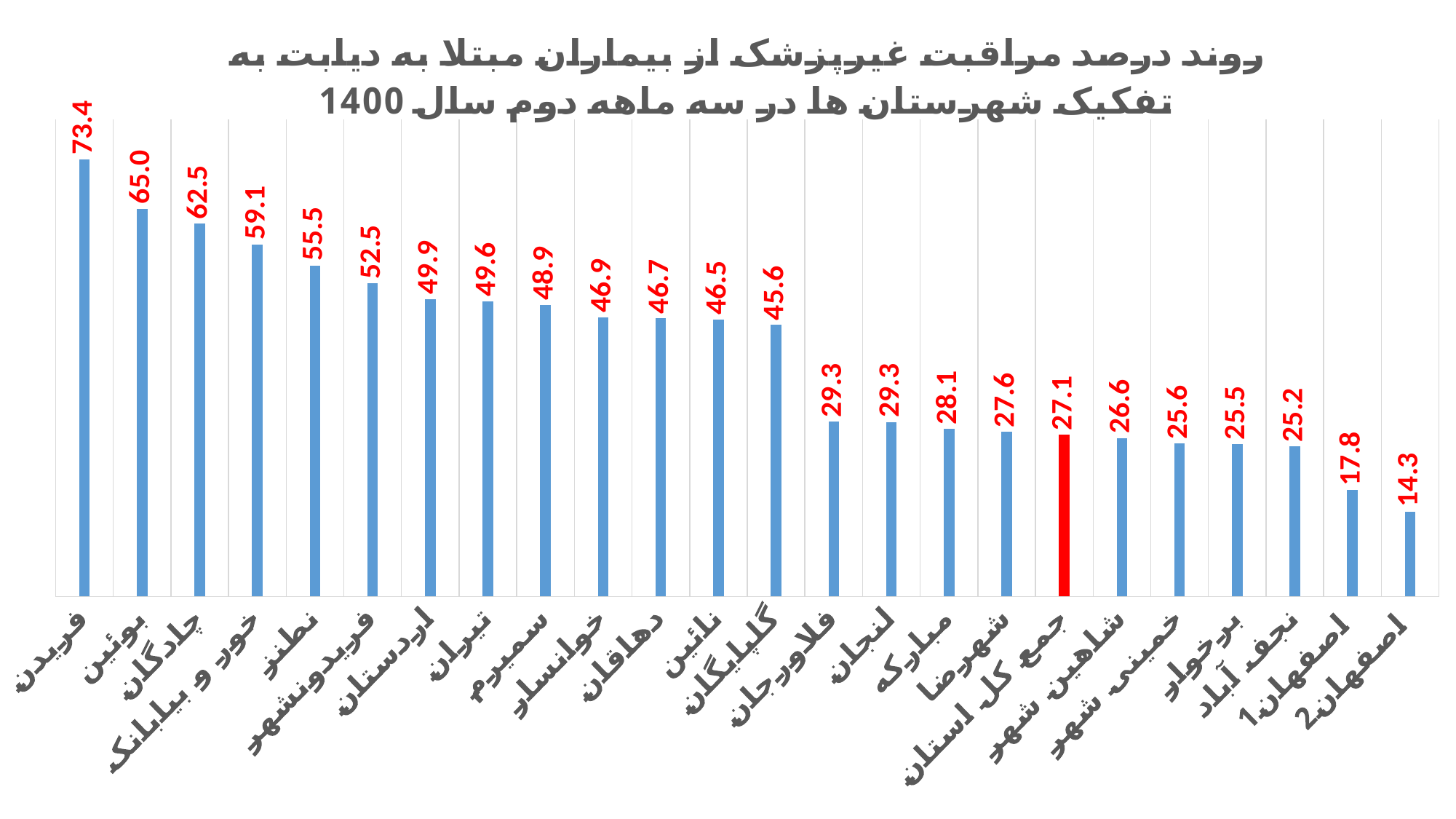
What is the value for اصفهان2? 14.3 What kind of chart is shown on the slide? bar chart What is the difference between the values for جمع کل استان and اصفهان1? 9.3 What is the value for جمع کل استان? 27.1 What is the value for نطنز? 55.5 What is the difference between the values for فریدن and بوئین? 8.4 Which category has the highest value? فریدن Which category has the lowest value? اصفهان2 Which is larger, the value for گلپایگان or the value for فلاورجان? گلپایگان What is the value for فریدن? 73.4 Which bar is coloured red instead of blue? جمع کل استان How many categories are shown in the chart? 24